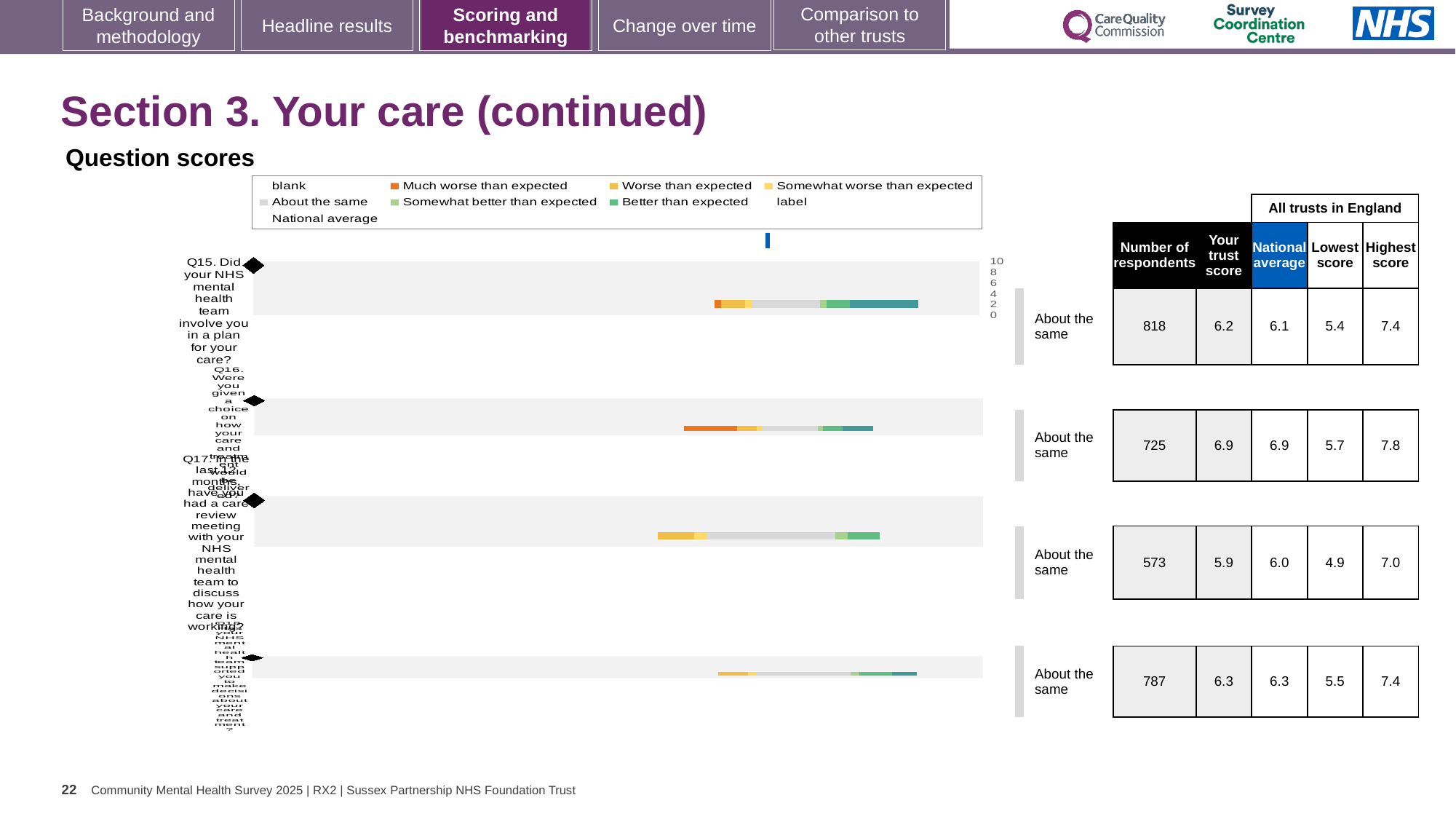
What is the highest score among all trusts in England shown for Q16? 7.8 By how much does the trust score for Q15 exceed the national average for Q15? 0.1 How many questions are plotted as bars in the question scores chart? 4 What kind of chart is used to show the question scores on this slide? bar chart In the table beside the chart, what is the 'Your trust score' for Q15 (Did your NHS mental health team involve you in a plan for your care?)? 6.2 What benchmark category is shown next to the bar for Q15? About the same How many respondents are listed for Q15 in the table beside the chart? 818 Which has the larger trust score, Q16 or Q17? Q16 What is the difference between the highest score (7.0) and the lowest score (4.9) for Q17? 2.1 Which question has the lowest number of respondents in the table beside the chart? Q17 Which question has the highest 'Your trust score' in the table beside the chart? Q16 What is the national average score shown for Q17 (care review meeting in the last 12 months)? 6.0